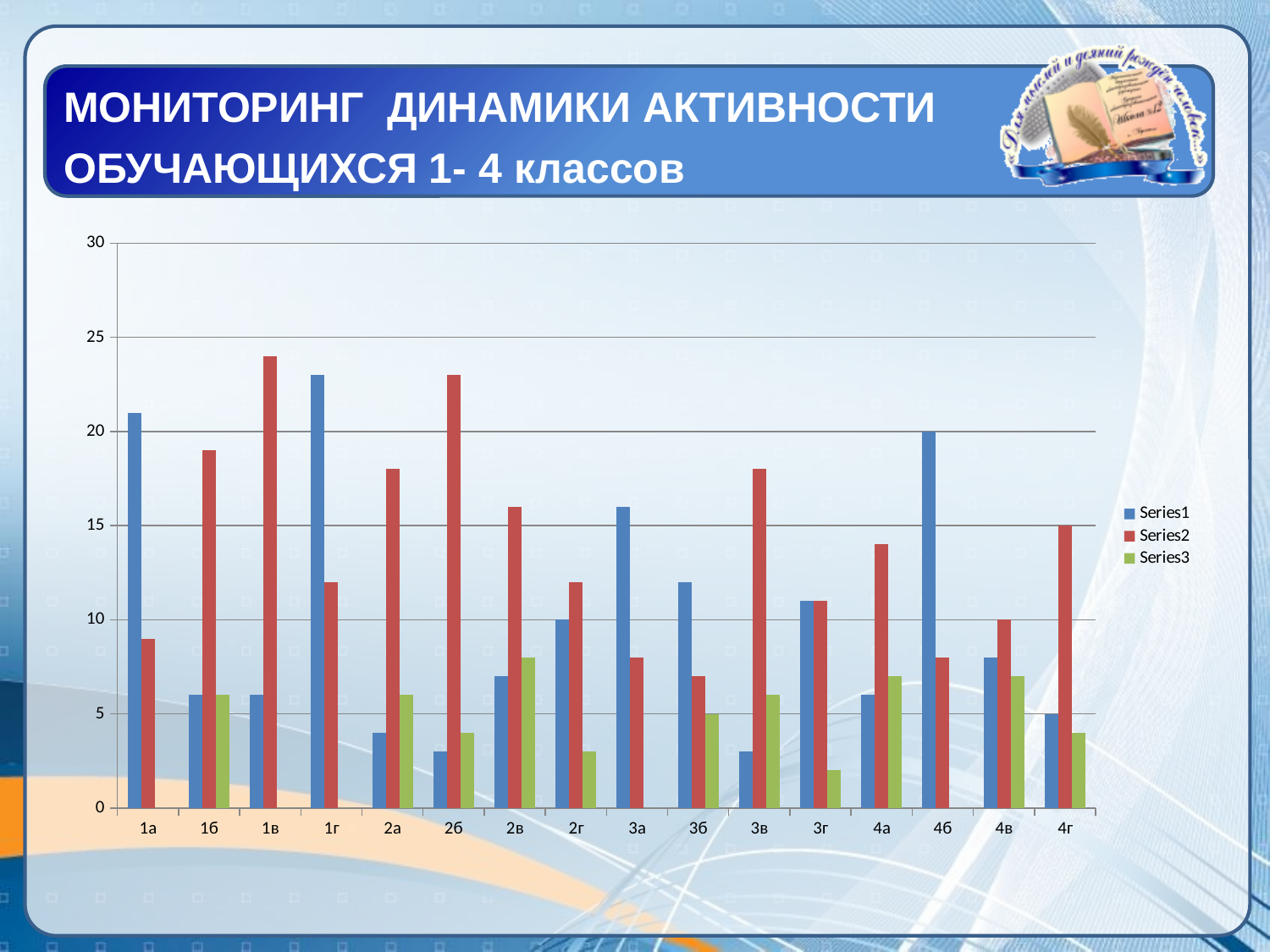
What kind of chart is shown on the slide? bar chart What is the value of Series2 for 4г? 15 What is the value of Series1 for 2г? 10 Which category has the highest Series1 value? 1г For 1а, which is larger: Series1 or Series2? Series1 What are the legend entries of the chart? Series1, Series2, Series3 Is the value of Series1 for 2а greater or less than 5? less Is the value of Series2 for 1в greater or less than 20? greater What is the value of Series1 for 4б? 20 How many series does the legend list? 3 How many categories are shown on the x axis? 16